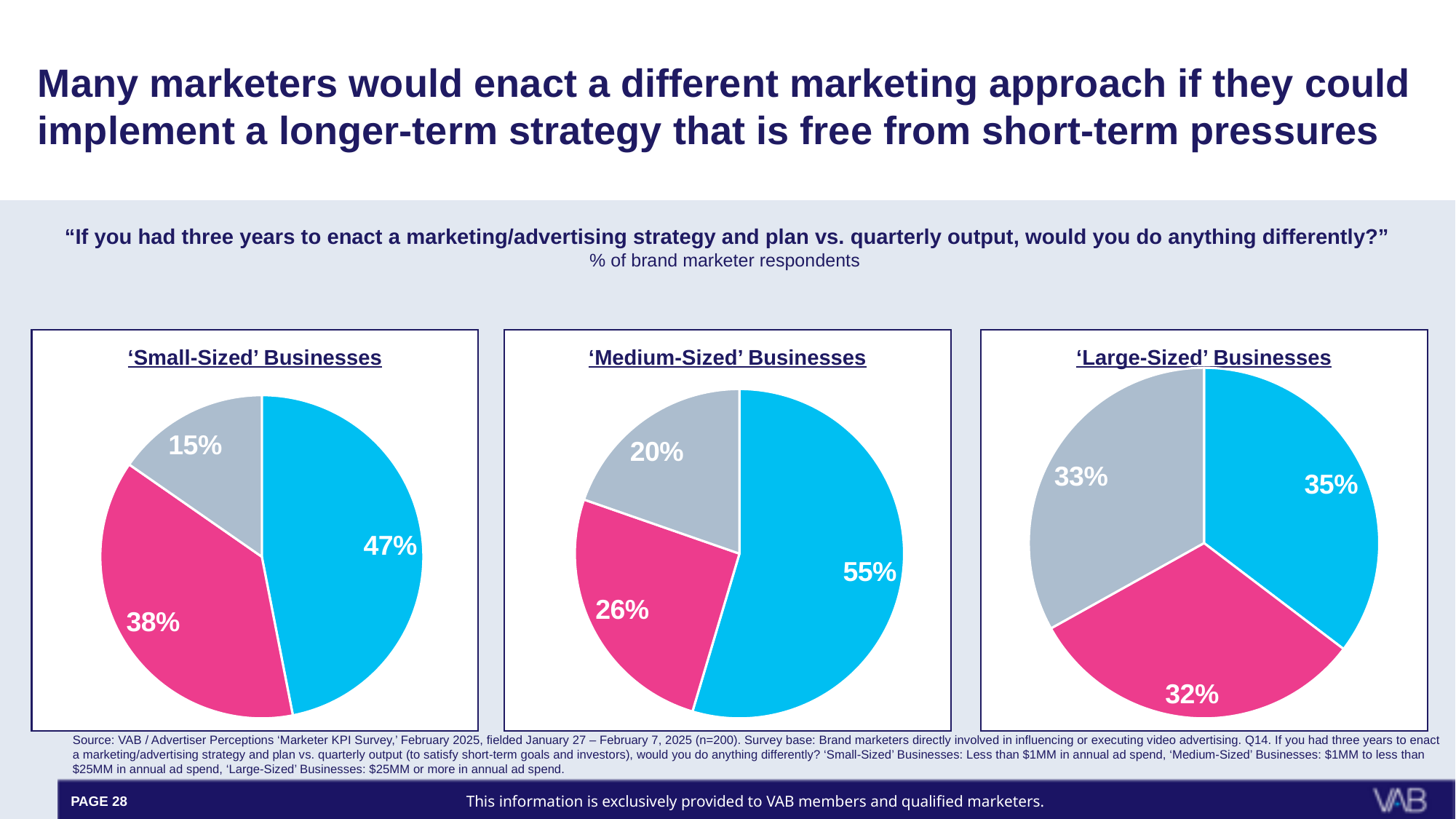
In the 'Small-Sized' Businesses pie chart, which slice is the smallest? The grey slice (15%) In the 'Large-Sized' Businesses pie chart, what percentage is shown on the grey slice? 33% What is the title of the pie chart on the right of the slide? 'Large-Sized' Businesses In the 'Medium-Sized' Businesses pie chart, which slice is the largest? The blue slice (55%) In the 'Medium-Sized' Businesses pie chart, what percentage is shown on the pink slice? 26% In the 'Medium-Sized' Businesses pie chart, what is the difference between the blue slice and the grey slice? 35 percentage points How many slices does the 'Large-Sized' Businesses pie chart have? 3 How many pie charts are shown on the slide? 3 Which is larger: the blue slice in the 'Small-Sized' Businesses chart or the blue slice in the 'Medium-Sized' Businesses chart? The 'Medium-Sized' Businesses blue slice (55%) In the 'Small-Sized' Businesses pie chart, what percentage is shown on the blue slice? 47% In the 'Small-Sized' Businesses pie chart, what is the difference between the blue slice and the pink slice? 9 percentage points What kind of chart is used for the 'Small-Sized' Businesses data? Pie chart